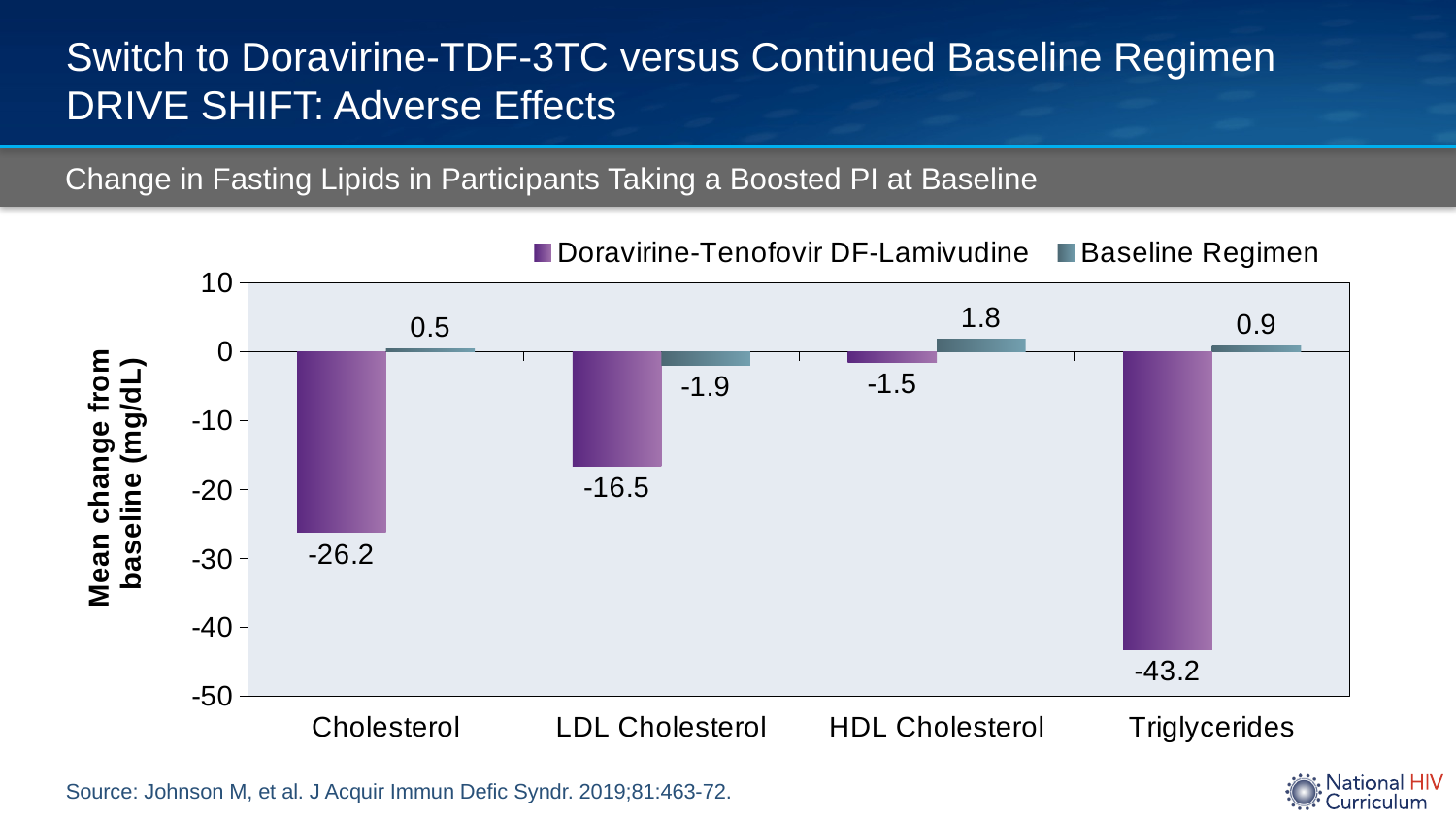
What is the mean change from baseline in HDL cholesterol for the Doravirine-Tenofovir DF-Lamivudine group? -1.5 What is the mean change from baseline in triglycerides for the Baseline Regimen group? 0.9 What is the label of the y axis? Mean change from baseline (mg/dL) What is the mean change from baseline in LDL cholesterol for the Baseline Regimen group? -1.9 How many series does the legend list? 2 What is the mean change from baseline in cholesterol for the Doravirine-Tenofovir DF-Lamivudine group? -26.2 How many lipid categories are shown on the x axis? 4 What kind of chart is shown on the slide? Bar chart What is the difference between the Doravirine-Tenofovir DF-Lamivudine and Baseline Regimen values for LDL cholesterol? 14.6 For which lipid category does the Doravirine-Tenofovir DF-Lamivudine group show the largest decrease from baseline? Triglycerides For which lipid category does the Baseline Regimen group show the highest mean change from baseline? HDL Cholesterol